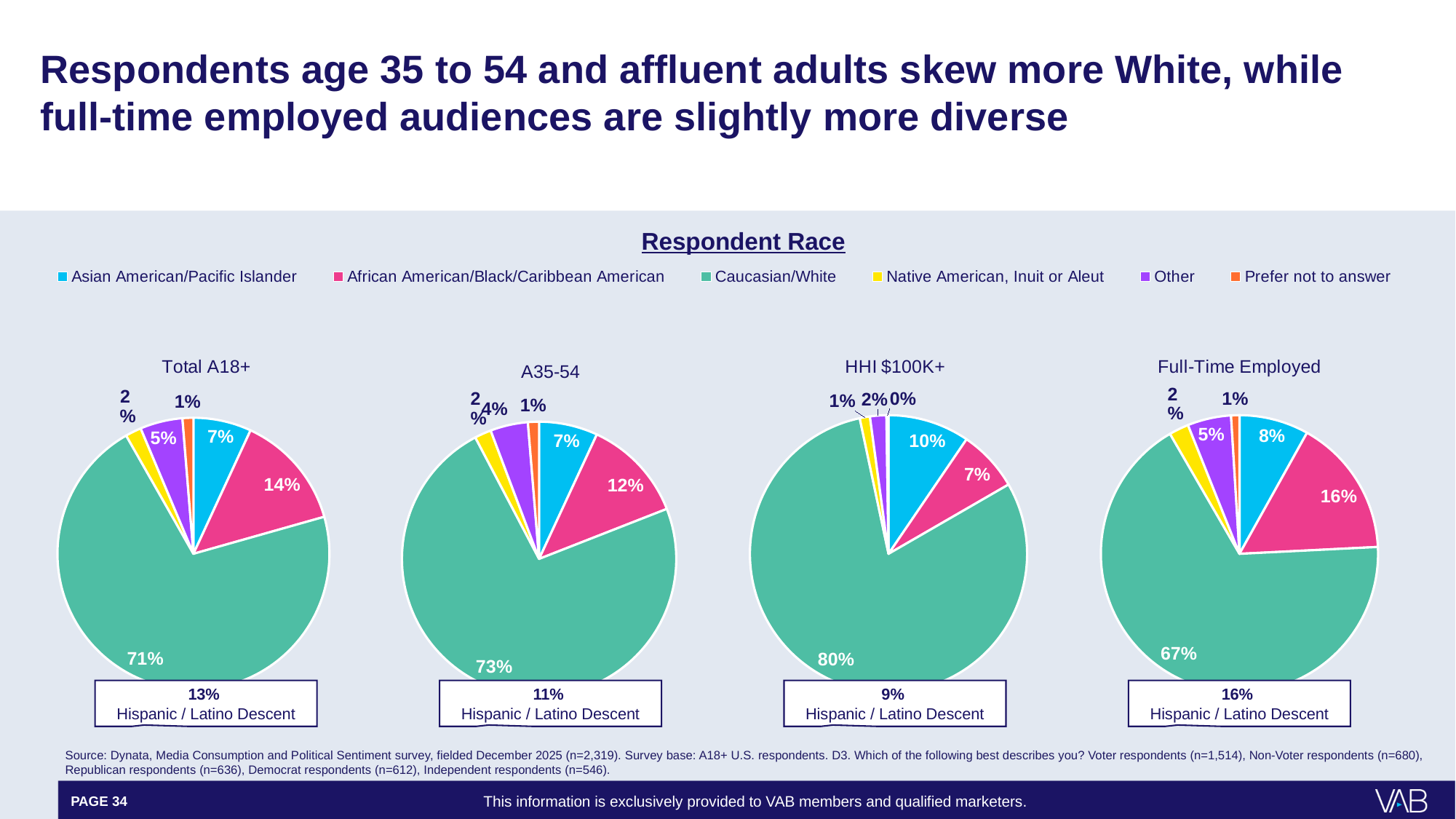
In the HHI $100K+ pie chart, what share is Asian American/Pacific Islander? 10% In the Full-Time Employed pie chart, what share is Caucasian/White? 67% How many pie charts are on the slide? 4 In the Full-Time Employed pie chart, which category has the smallest share? Prefer not to answer How many series does the legend list? 6 In the HHI $100K+ pie chart, which category has the largest share? Caucasian/White What is the difference between the Caucasian/White share in the HHI $100K+ chart and in the Full-Time Employed chart? 13% Which is larger: the African American/Black/Caribbean American share in the Total A18+ chart or in the HHI $100K+ chart? Total A18+ What kind of charts are shown on the slide? Pie charts In the A35-54 pie chart, what share is African American/Black/Caribbean American? 12% What is the title shown above the legend for the charts? Respondent Race In the Total A18+ pie chart, what share is Caucasian/White? 71%